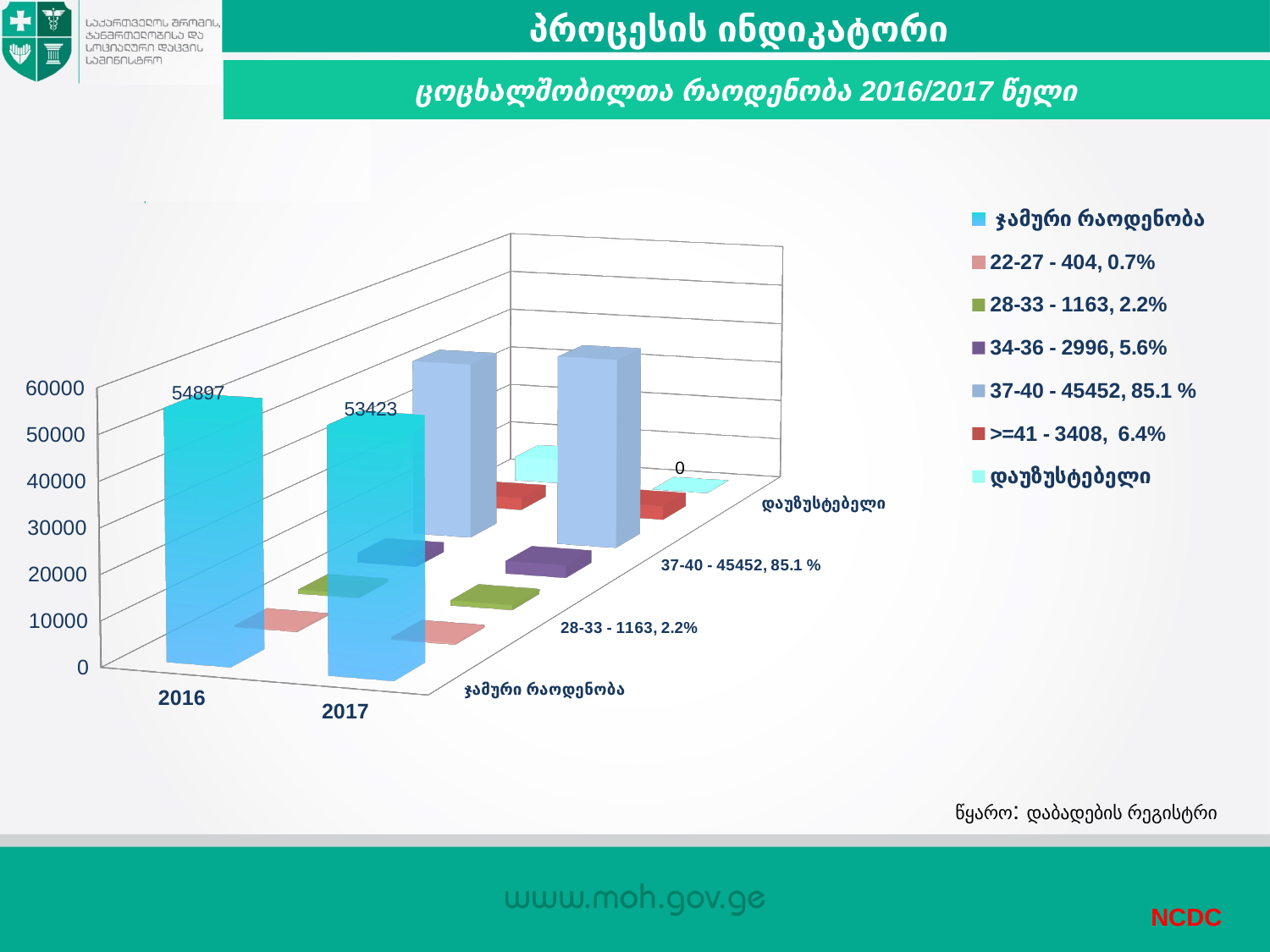
Is the value for the 22-27 series in 2016 greater or less than 10000? less What is the data label shown on the დაუზუსტებელი bar for 2017? 0 What is the value of ჯამური რაოდენობა for 2017? 53423 Does the ჯამური რაოდენობა value rise or fall from 2016 to 2017? fall Which year has the larger ჯამური რაოდენობა value, 2016 or 2017? 2016 What is the value of ჯამური რაოდენობა for 2016? 54897 How many years are shown on the x axis? 2 What is the subtitle of the chart shown on the slide? ცოცხალშობილთა რაოდენობა 2016/2017 წელი What kind of chart is shown on the slide? bar chart What is the difference between the ჯამური რაოდენობა values for 2016 and 2017? 1474 Is the ჯამური რაოდენობა value for 2017 greater or less than 50000? greater How many series does the legend list? 7